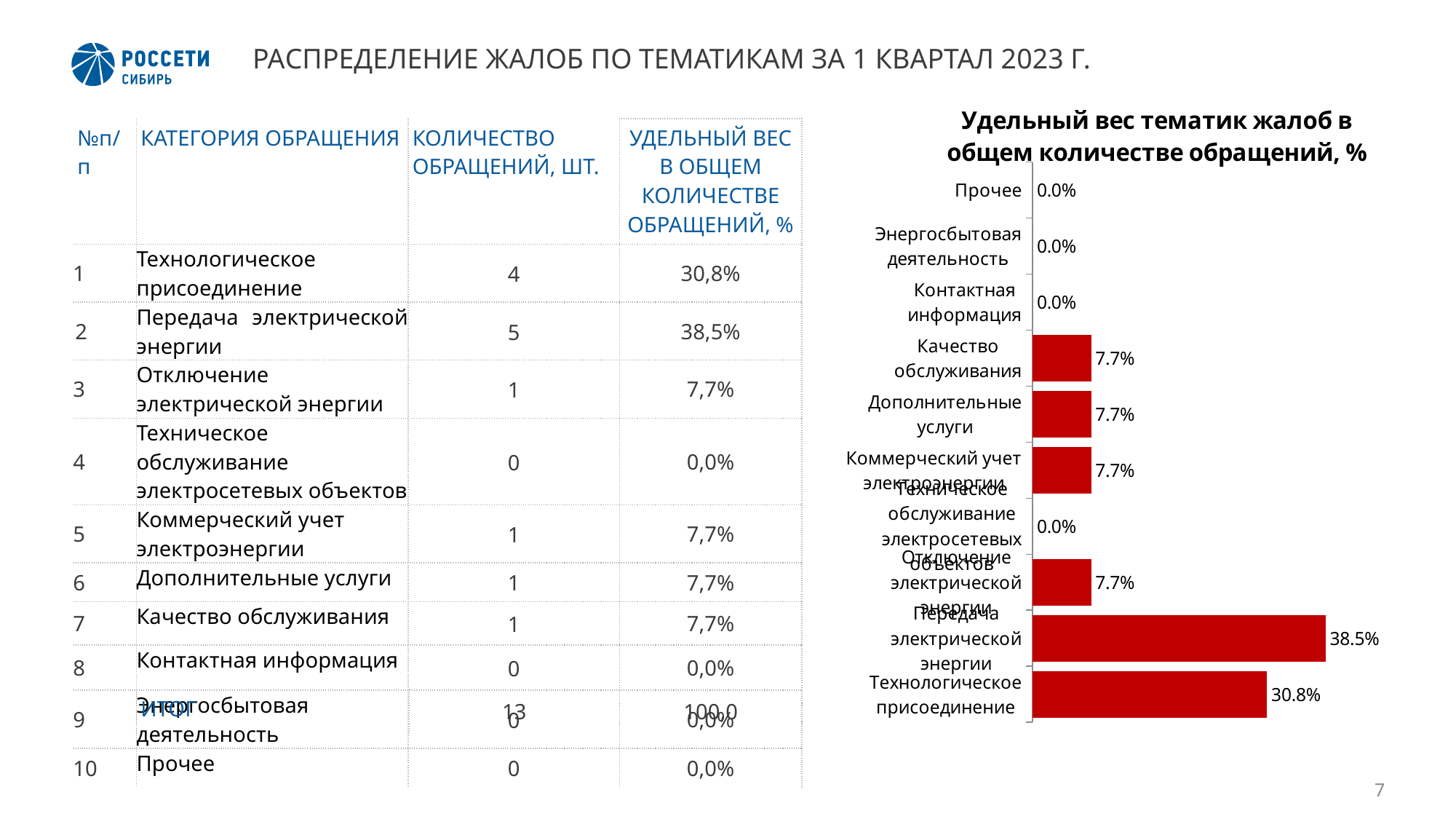
Which category has the highest value in the chart? Передача электрической энергии What is the value for Качество обслуживания in the chart? 7.7% What type of chart is shown on the slide? bar chart Which is larger in the chart: the value for Технологическое присоединение or the value for Отключение электрической энергии? Технологическое присоединение What is the value for Технологическое присоединение in the chart? 30.8% How many categories in the chart have a value of 0.0%? 4 What colour are the bars in the chart? red What is the value for Контактная информация in the chart? 0.0% What is the difference between the values for Передача электрической энергии and Технологическое присоединение? 7.7% What is the title of the chart? Удельный вес тематик жалоб в общем количестве обращений, % What is the value for Передача электрической энергии in the chart? 38.5% How many categories are plotted in the chart? 10